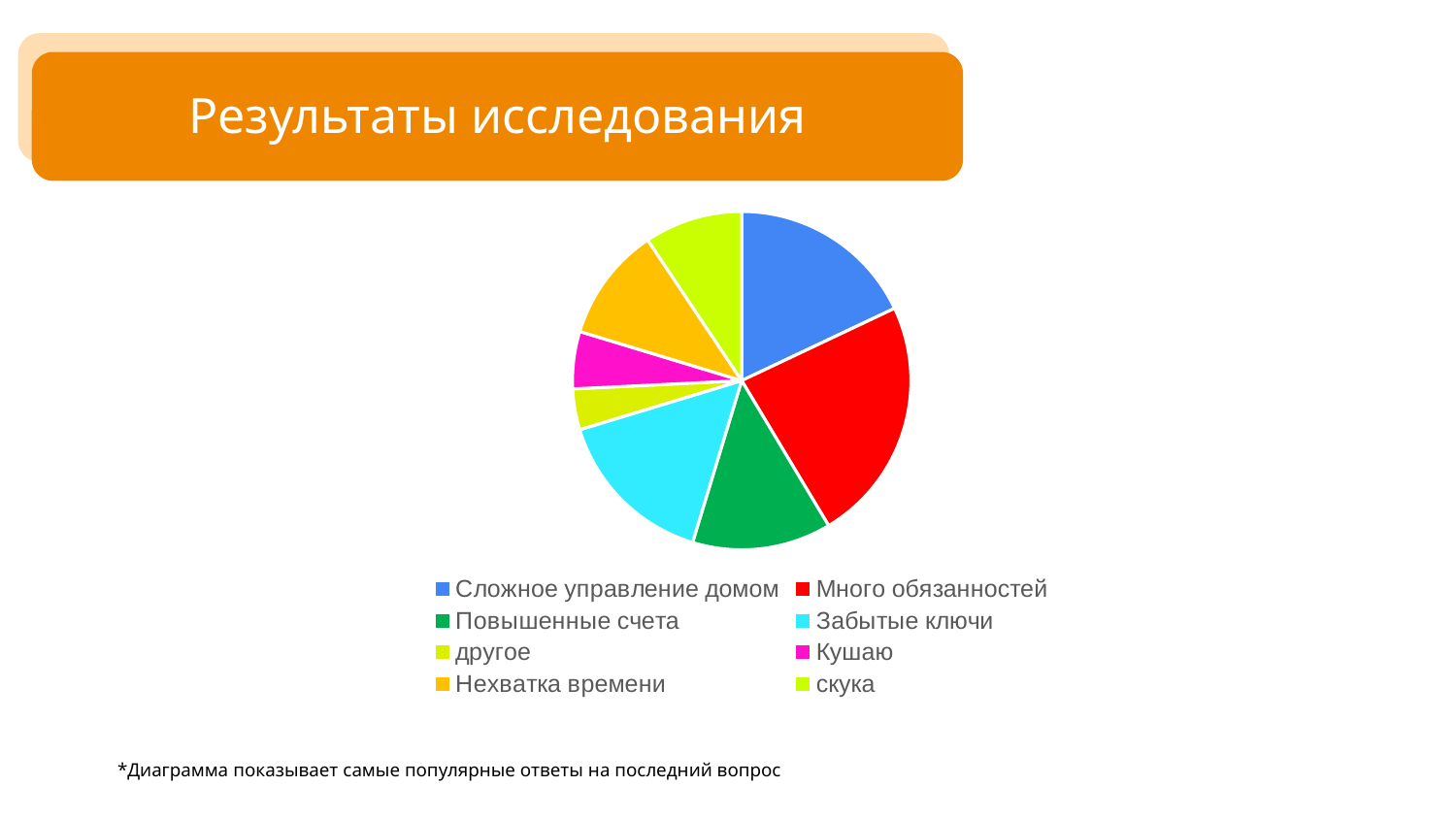
How many slices does the pie chart have? 8 Which slice is larger: Забытые ключи or другое? Забытые ключи What kind of chart is shown on the slide? Pie chart Which slice is larger: Много обязанностей or Сложное управление домом? Много обязанностей Which category has the largest slice in the pie chart? Много обязанностей What colour is the slice for Много обязанностей in the pie chart? Red Which slice is larger: Сложное управление домом or Кушаю? Сложное управление домом How many entries does the legend of the pie chart list? 8 What is the title of the slide containing the pie chart? Результаты исследования